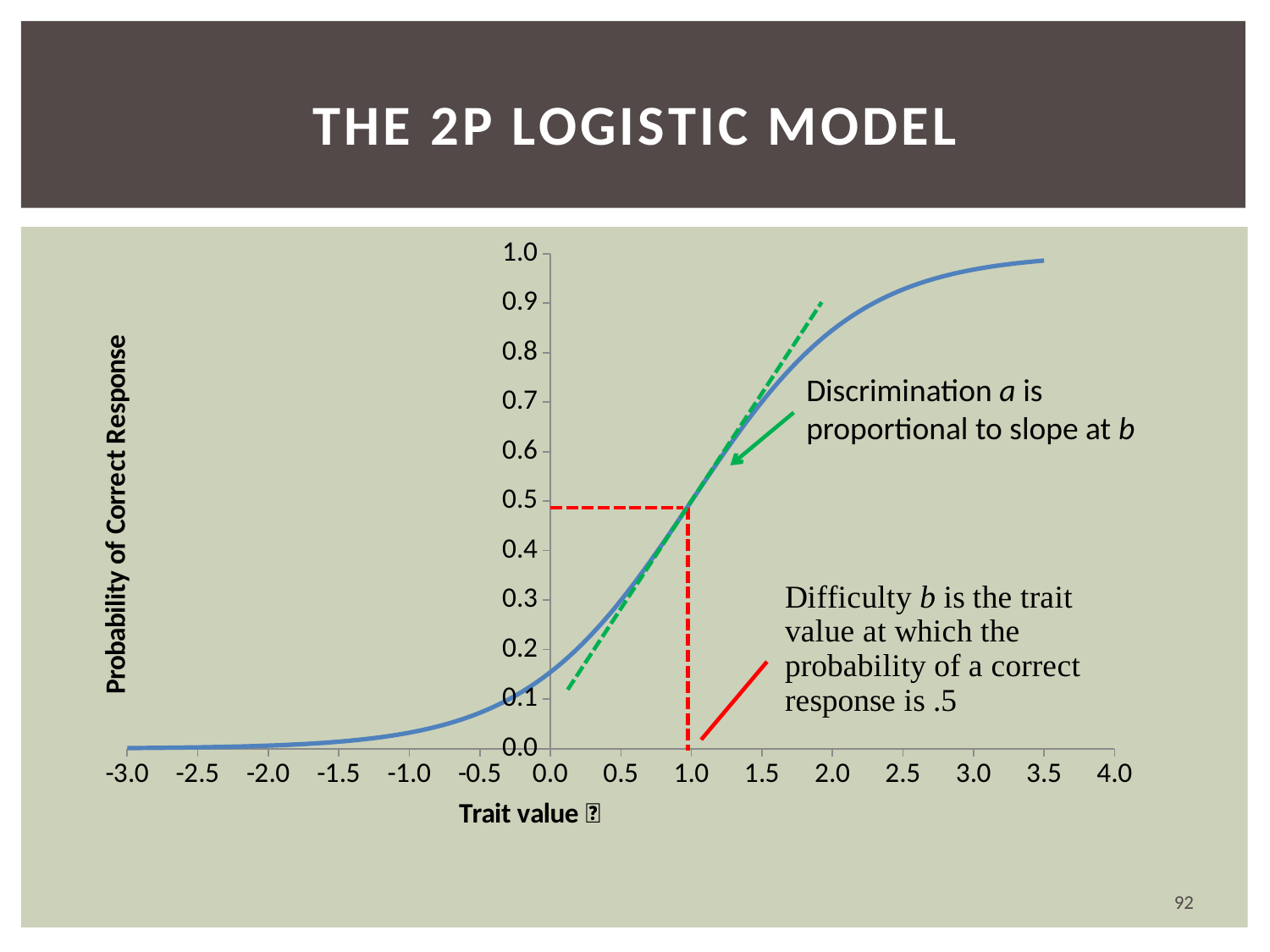
Is the probability of a correct response at a trait value of 0.5 greater or less than 0.5? less What is the label of the vertical axis? Probability of Correct Response Is the probability of a correct response at a trait value of 2.0 greater or less than 0.8? greater What is the probability of a correct response at a trait value of 1.0, where the red dashed lines meet the curve? 0.5 Which is larger: the probability of a correct response at a trait value of 2.0 or at a trait value of 0.0? 2.0 What kind of chart is shown on the slide? line chart Is the probability of a correct response at a trait value of 3.0 greater or less than 0.9? greater Does the probability of a correct response rise or fall as the trait value increases? rise What is the title of the slide containing the chart? THE 2P LOGISTIC MODEL How many curves (data series) are plotted on the chart? 1